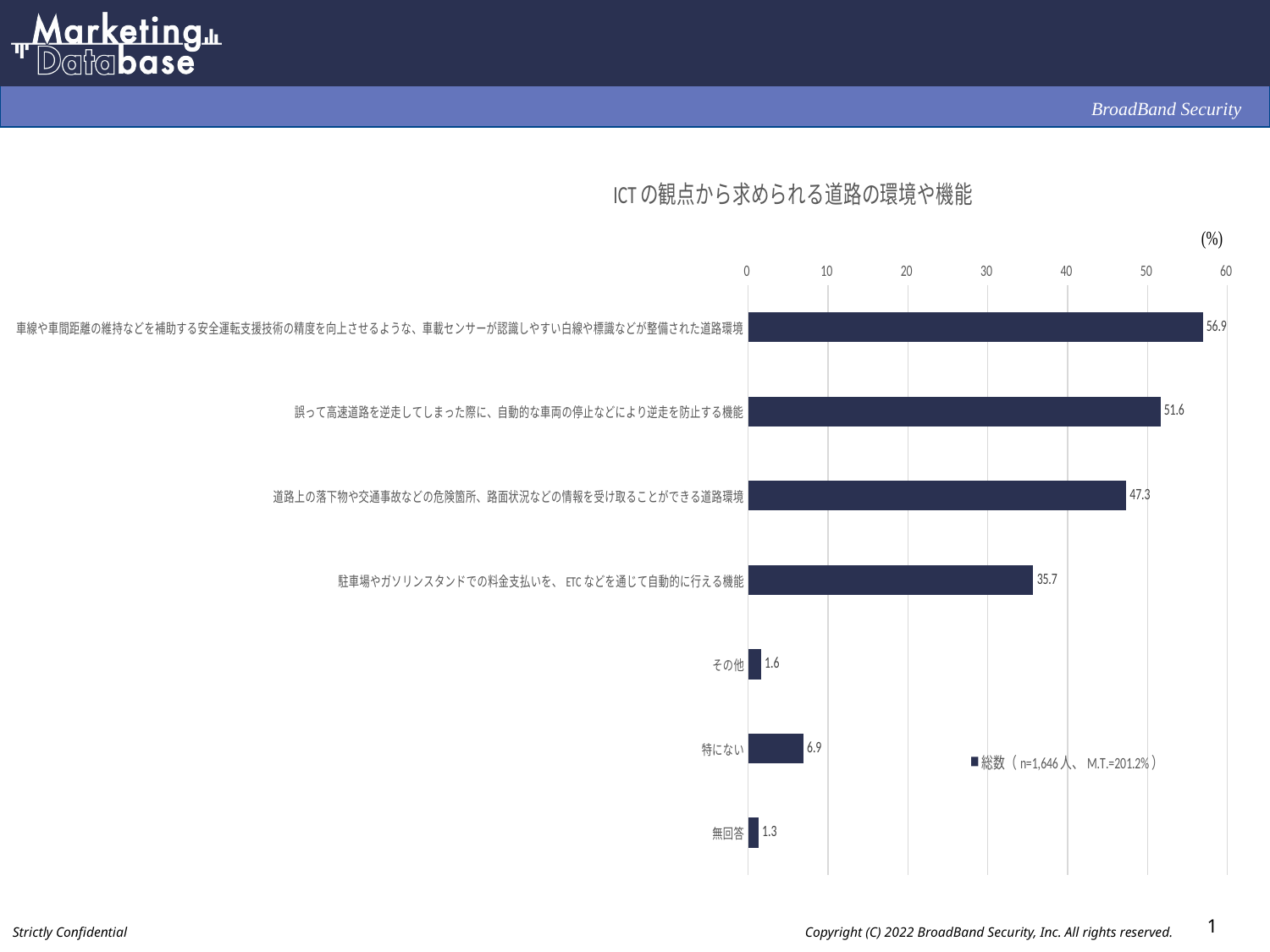
What is the value for 駐車場やガソリンスタンドでの料金支払いを、ETCなどを通じて自動的に行える機能? 35.7 How many categories are plotted in the chart? 7 Which category has the lowest value? 無回答 What is the difference between the values for 車線や車間距離の維持などを補助する安全運転支援技術の精度を向上させるような、車載センサーが認識しやすい白線や標識などが整備された道路環境 and 道路上の落下物や交通事故などの危険箇所、路面状況などの情報を受け取ることができる道路環境? 9.6 Which is larger, the value for その他 or the value for 特にない? 特にない Which category has the highest value? 車線や車間距離の維持などを補助する安全運転支援技術の精度を向上させるような、車載センサーが認識しやすい白線や標識などが整備された道路環境 What is the value for 誤って高速道路を逆走してしまった際に、自動的な車両の停止などにより逆走を防止する機能? 51.6 How many series does the legend list? 1 What is the value for 特にない? 6.9 What is the title of the chart? ICTの観点から求められる道路の環境や機能 What type of chart is shown on the slide? bar chart What is the sample size (n) shown in the legend? n=1,646人